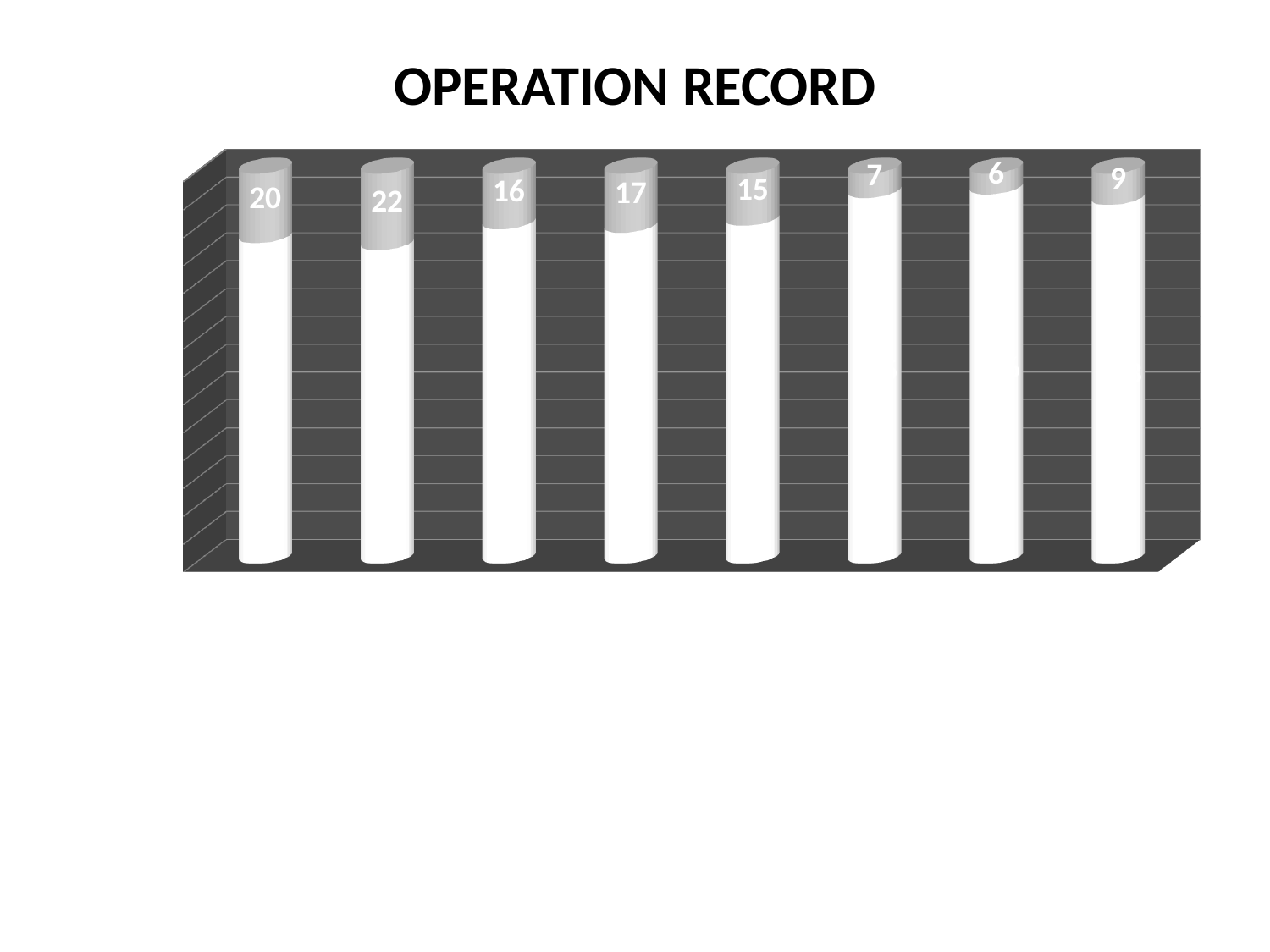
How many bars are plotted in the chart? 8 What is the value shown on the first (leftmost) bar? 20 What kind of chart is shown on the slide? bar chart What is the difference between the highest value (22) and the lowest value (6)? 16 What is the highest value shown in the chart? 22 What is the lowest value shown in the chart? 6 What is the value shown on the fifth bar from the left? 15 Is the value of the first bar (20) greater or less than the value of the last bar (9)? greater What is the value shown on the second bar from the left? 22 Which is larger, the value of the third bar (16) or the fourth bar (17)? 17 What is the value shown on the last (rightmost) bar? 9 What is the title of the chart? OPERATION RECORD